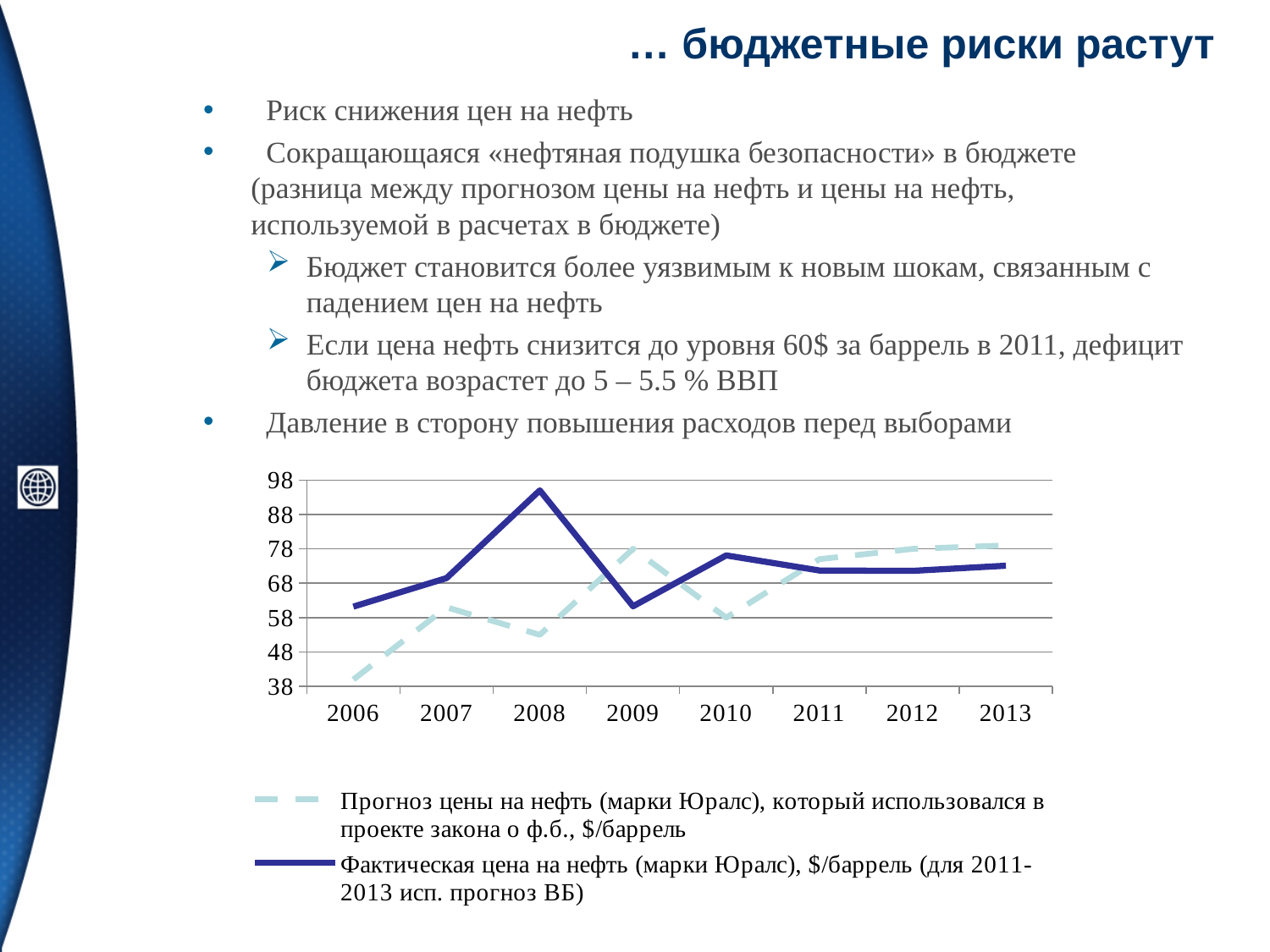
Which series is drawn with a dashed line in the chart? Прогноз цены на нефть (марки Юралс), который использовался в проекте закона о ф.б., $/баррель How many series does the chart legend list? 2 How many years are shown on the x axis of the chart? 8 Does the forecast oil price used in the budget law (dashed line) rise or fall from 2010 to 2013? rise Is the actual oil price (solid line) in 2010 greater or less than 68? greater In which year is the forecast oil price used in the budget law (dashed line) at its lowest? 2006 Is the forecast oil price used in the budget law (dashed line) in 2008 greater or less than 58? less In which year does the actual Urals oil price (solid line) reach its highest value? 2008 Is the actual oil price (solid line) in 2008 greater or less than 88? greater In 2009, which is larger: the forecast price used in the budget law or the actual oil price? the forecast price used in the budget law What kind of chart is shown on the slide? line chart